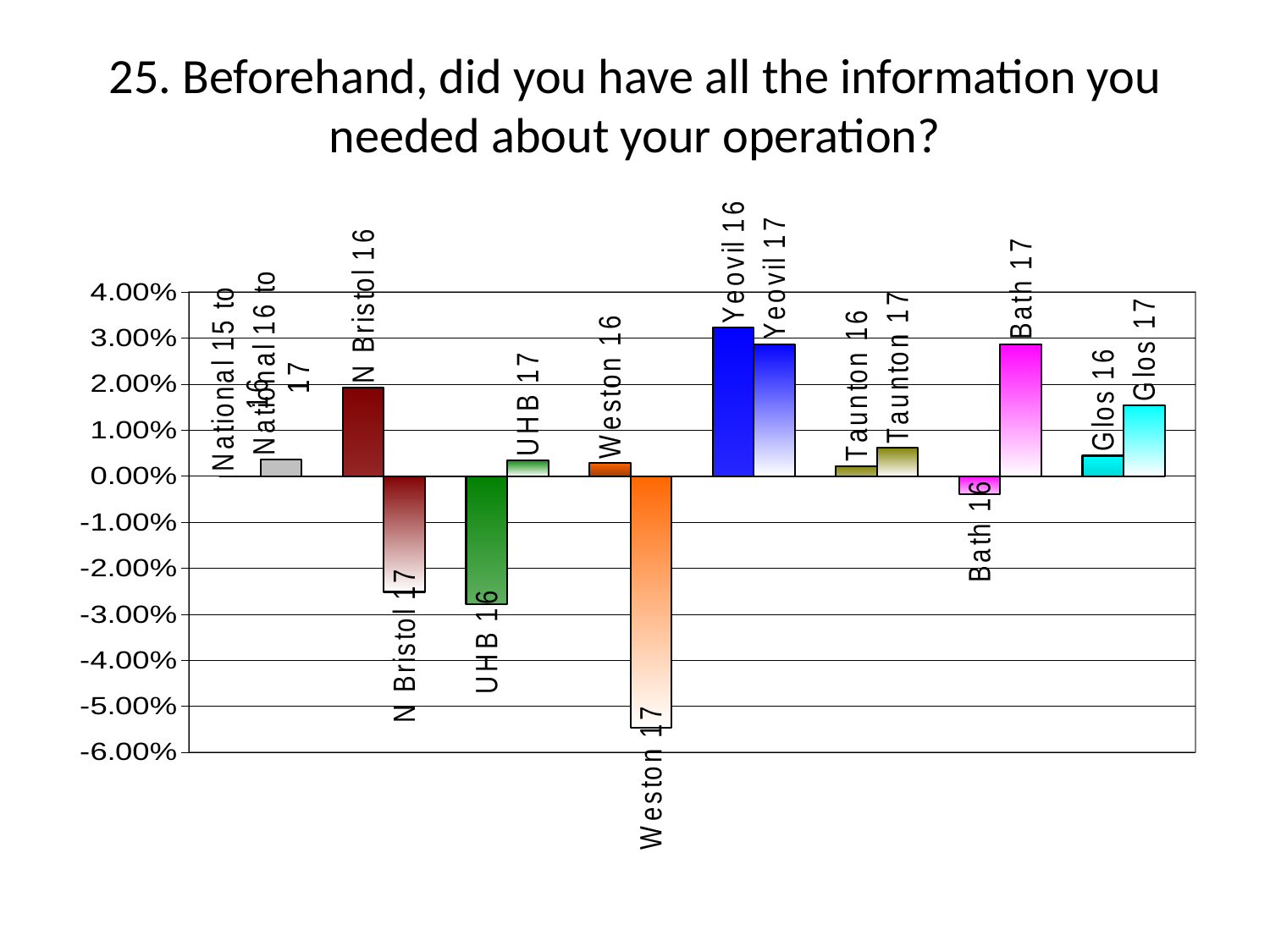
What kind of chart is shown on the slide? bar chart Is the value for Yeovil 16 greater or less than 3.00%? greater Which category has the lowest value on the chart? Weston 17 Is the value for UHB 16 greater or less than -2.00%? less Is the value for Glos 17 greater or less than 1.00%? greater Which category has the highest value on the chart? Yeovil 16 What is the title of the chart on the slide? 25. Beforehand, did you have all the information you needed about your operation? Which is larger, the value for N Bristol 16 or the value for Glos 17? N Bristol 16 How many categories (bars) are plotted on the chart? 15 Which is larger, the value for UHB 16 or the value for Weston 17? UHB 16